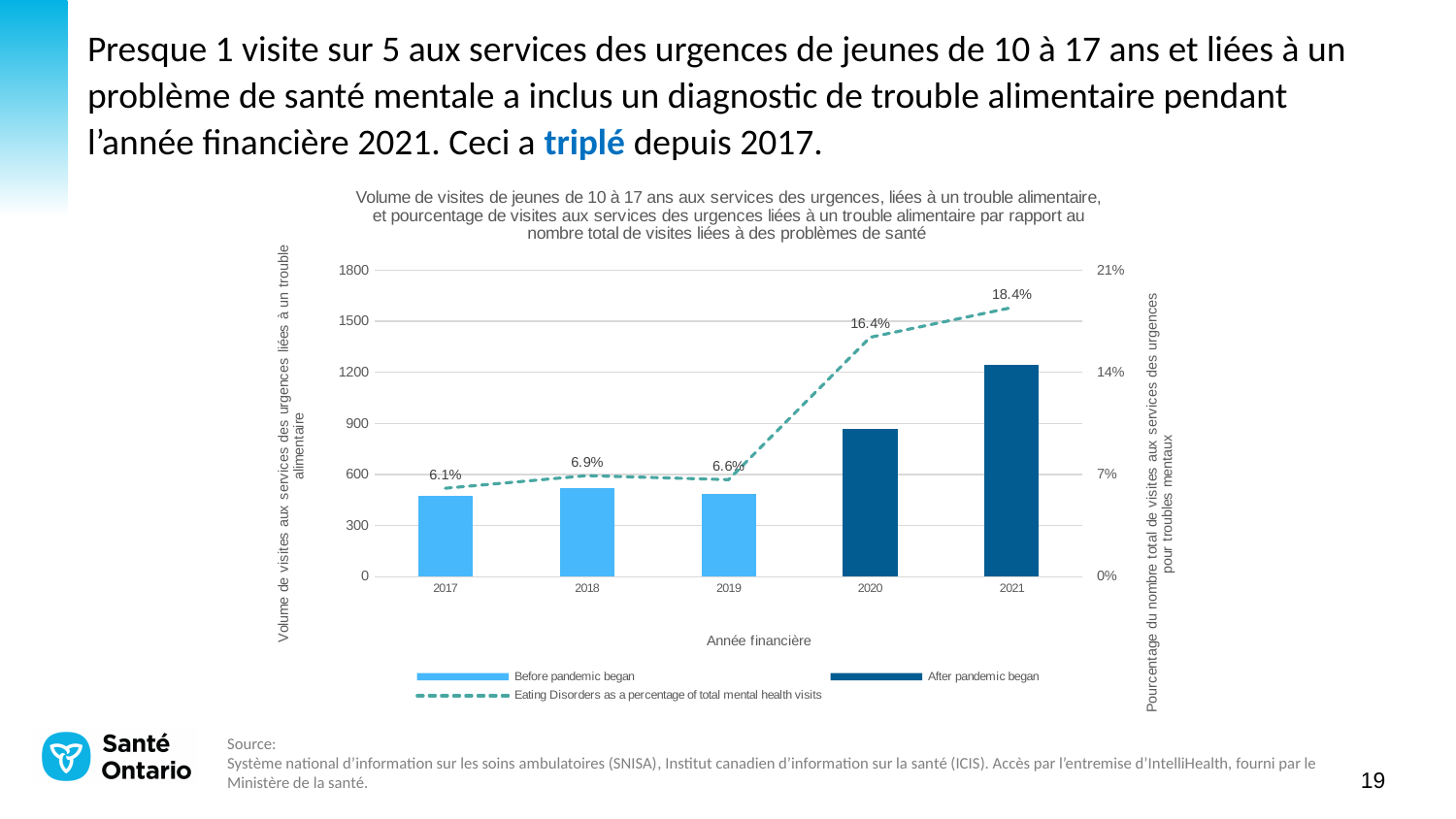
Is the volume of visits (bar) for 2021 greater or less than 900? greater Which financial year has the lowest percentage on the dashed line? 2017 By how many percentage points did the eating-disorder share rise from 2017 to 2021? 12.3 percentage points Is the volume of visits (bar) for 2017 greater or less than 600? less How many financial years are shown on the x axis? 5 Does the dashed percentage line rise or fall from 2017 to 2021? rises What percentage is shown on the dashed line for 2020? 16.4% Which financial year has the highest percentage on the dashed line? 2021 What percentage of total mental health visits were eating-disorder visits in 2021? 18.4% Which year has the higher percentage on the dashed line, 2018 or 2019? 2018 How many entries does the legend list? 3 What percentage is shown on the dashed line for 2017? 6.1%